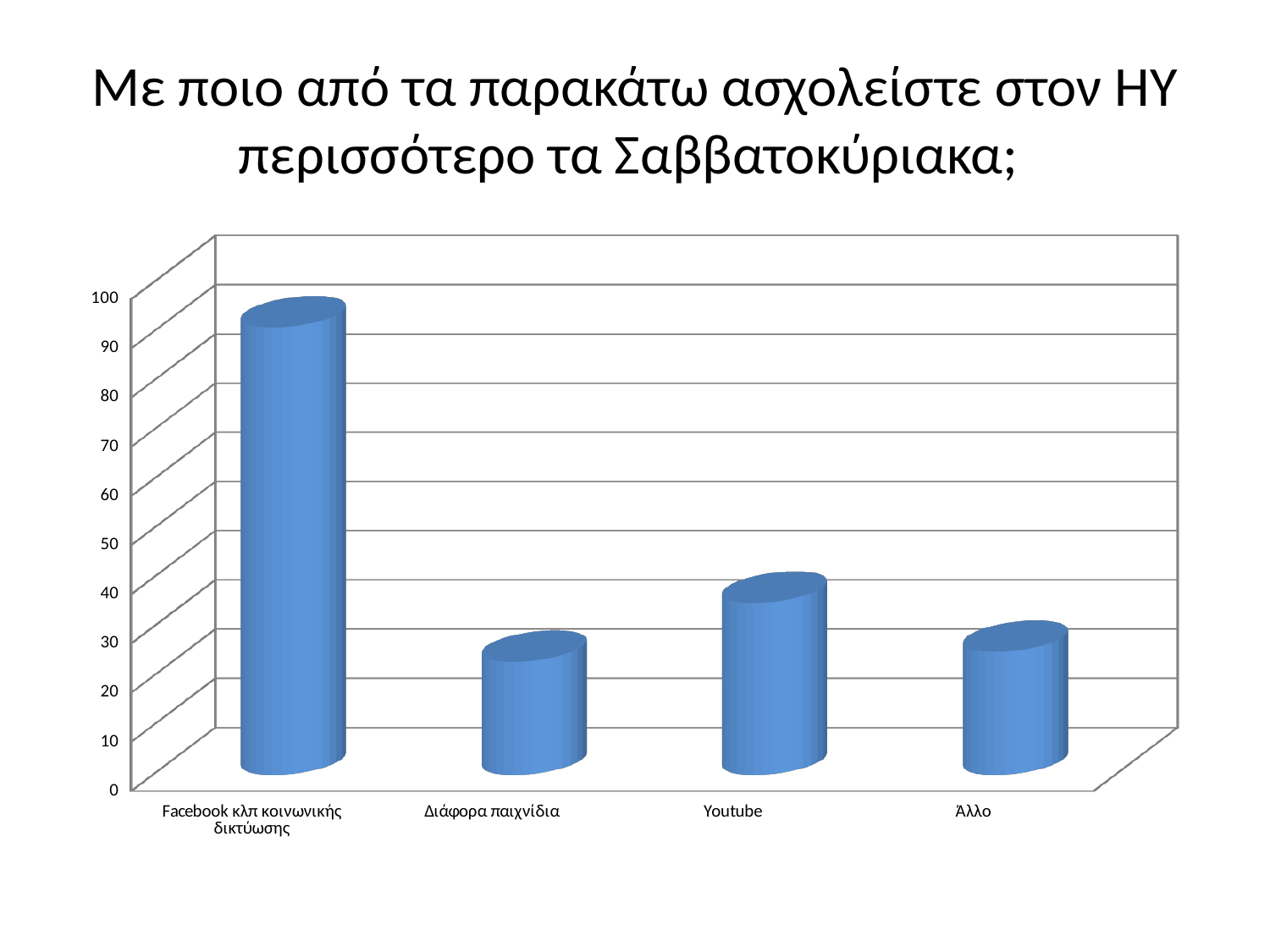
Is the value for Διάφορα παιχνίδια greater or less than 50? less What is the title of the slide containing the chart? Με ποιο από τα παρακάτω ασχολείστε στον ΗΥ περισσότερο τα Σαββατοκύριακα; Which is larger, the value for Facebook κλπ κοινωνικής δικτύωσης or the value for Youtube? Facebook κλπ κοινωνικής δικτύωσης Is the value for Facebook κλπ κοινωνικής δικτύωσης greater or less than 80? greater Is the value for Άλλο greater or less than 50? less How many categories are shown on the x axis of the chart? 4 Which is larger, the value for Youtube or the value for Διάφορα παιχνίδια? Youtube Which category has the highest value in the chart? Facebook κλπ κοινωνικής δικτύωσης What is the highest value shown on the vertical axis of the chart? 100 What kind of chart is shown on the slide? bar chart